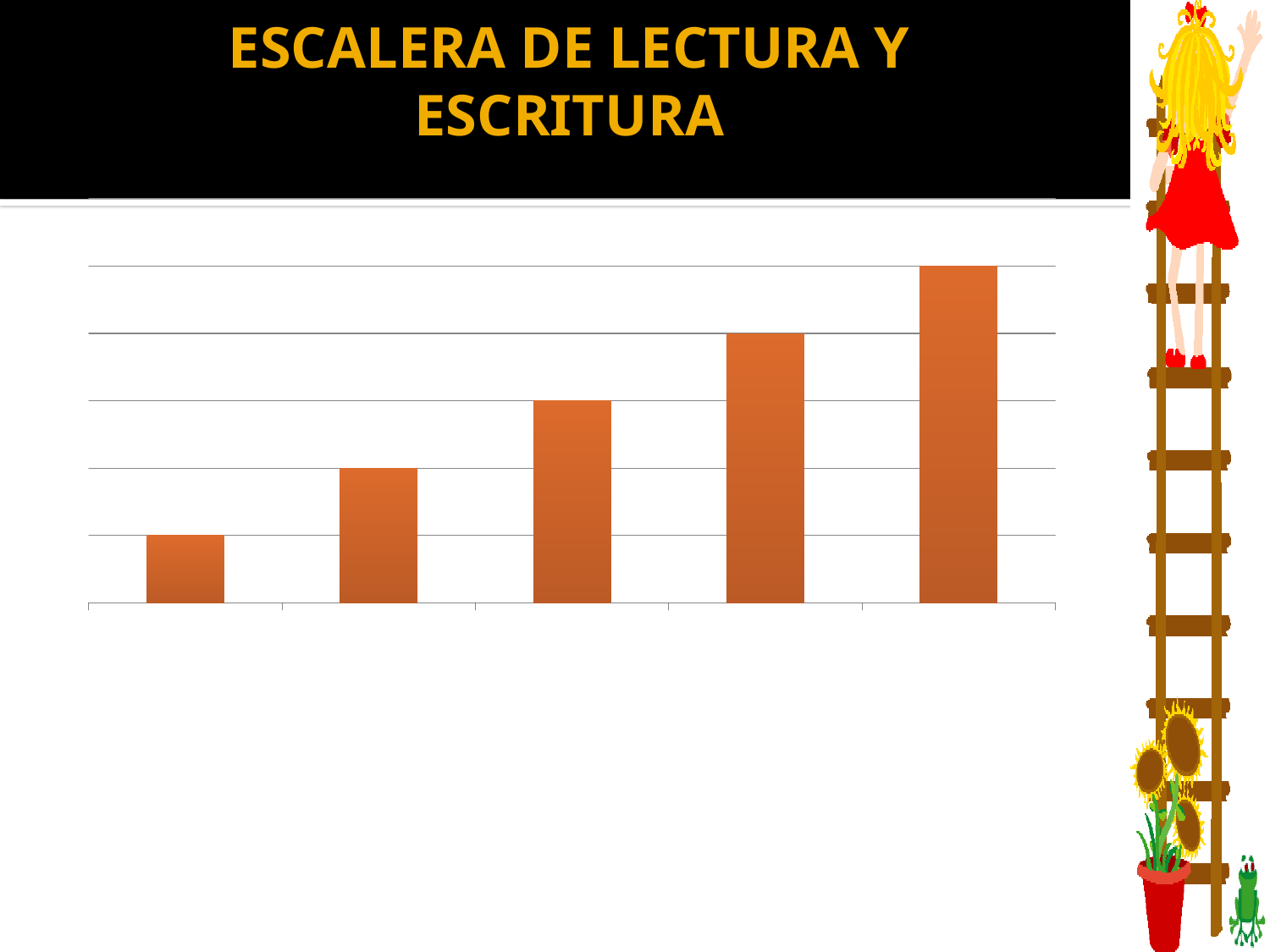
How many bars does the chart contain? 5 Which bar is the shortest: the leftmost or the rightmost? the leftmost What kind of chart is shown on the slide? bar chart Which is larger, the second bar from the left or the fourth bar from the left? the fourth bar from the left What colour are the bars in the chart? orange What is the title shown above the chart on the slide? ESCALERA DE LECTURA Y ESCRITURA Which is larger, the third bar from the left or the first bar from the left? the third bar from the left Which bar is the tallest: the leftmost or the rightmost? the rightmost Do the bar values rise or fall from left to right along the x axis? rise